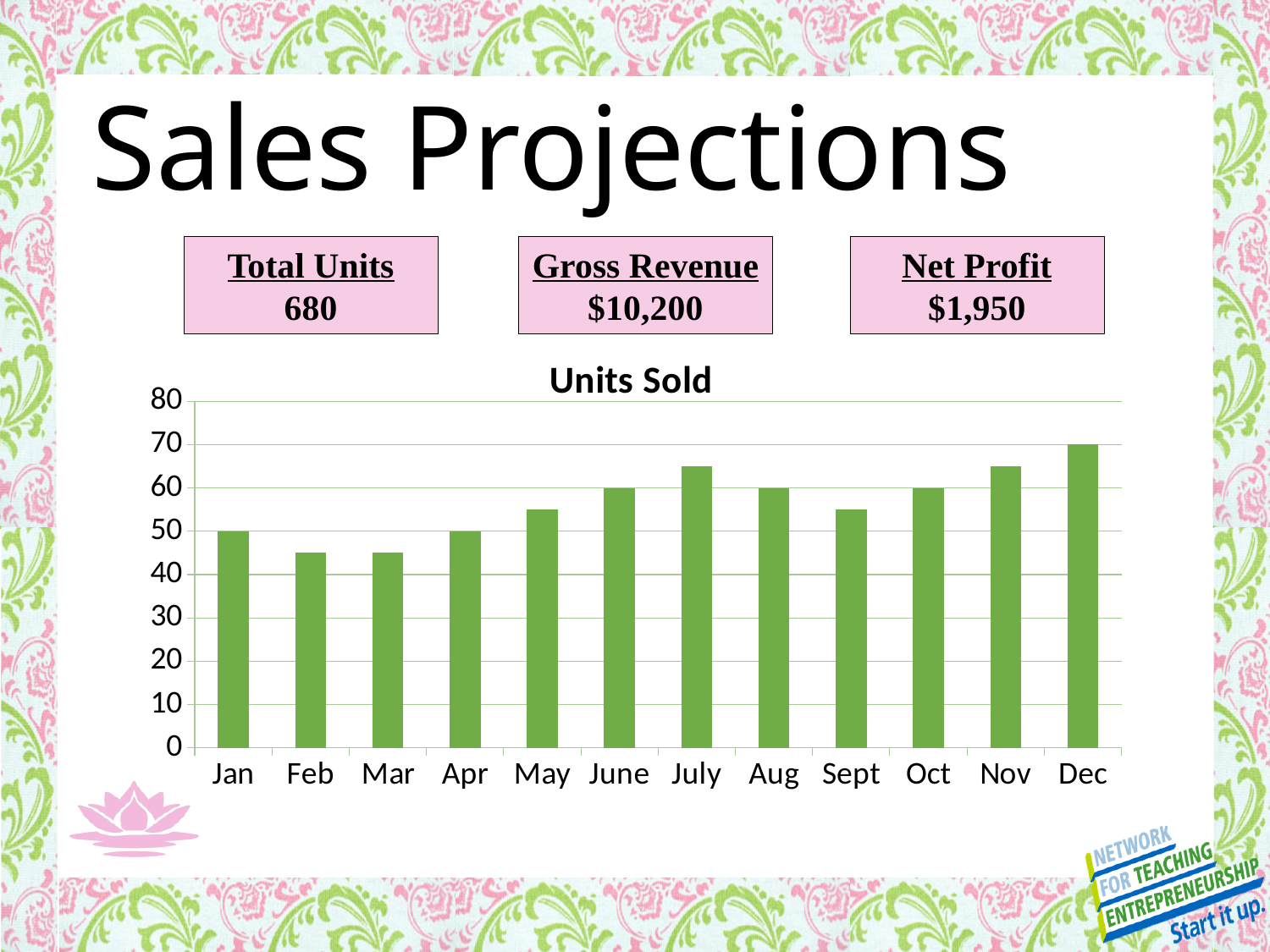
What is the value for Jan in the Units Sold chart? 50 Is the value for July in the Units Sold chart greater or less than 60? greater Which month has the highest value in the Units Sold chart? Dec What type of chart is shown on the slide? bar chart What is the value for Dec in the Units Sold chart? 70 What is the difference between the values for Dec and Jan in the Units Sold chart? 20 What is the title of the chart? Units Sold Is the value for Feb in the Units Sold chart greater or less than 50? less What is the value for June in the Units Sold chart? 60 Do the values in the Units Sold chart generally rise or fall from Jan to Dec? rise How many months are shown on the x axis of the Units Sold chart? 12 Which is larger in the Units Sold chart, the value for Dec or the value for Apr? Dec